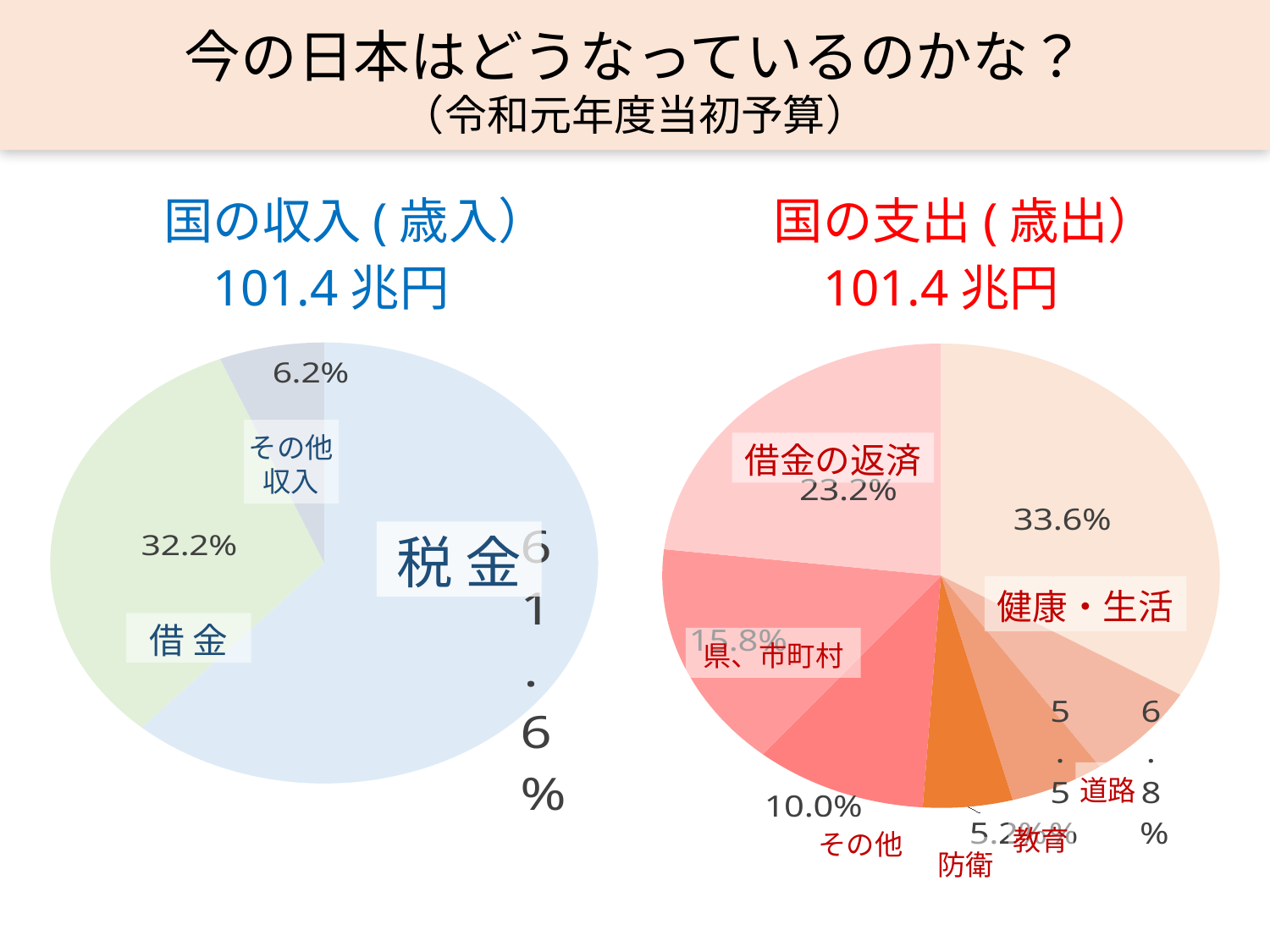
In the left pie chart (国の収入), what percentage is 税金? 61.6% In the right pie chart (国の支出), what percentage is 借金の返済? 23.2% In the left pie chart (国の収入), which slice is the smallest? その他収入 How many slices does the left pie chart (国の収入) have? 3 In the left pie chart (国の収入), how many percentage points larger is 税金 than 借金? 29.4 percentage points In the right pie chart (国の支出), what percentage is 県、市町村? 15.8% In the right pie chart (国の支出), which slice is the largest? 健康・生活 What kind of chart is used for 国の支出 on the right? Pie chart In the right pie chart (国の支出), what percentage is 健康・生活? 33.6% In the left pie chart (国の収入), what percentage is 借金? 32.2% In the left pie chart (国の収入), which slice is the largest? 税金 In the left pie chart (国の収入), what percentage is その他収入? 6.2%